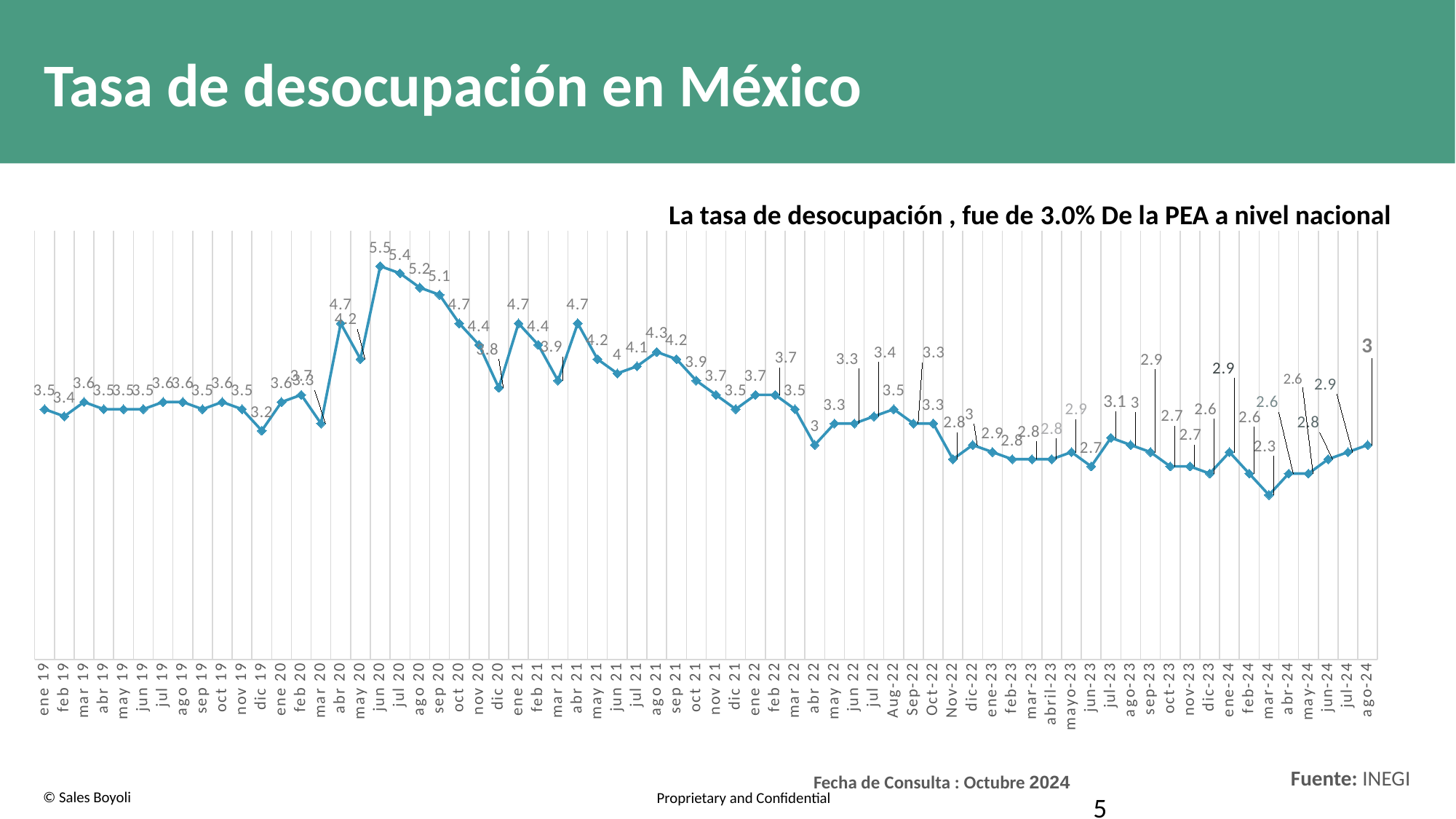
What is the value plotted for ago-24, the last point on the chart? 3 What is the unemployment rate value plotted for jun 20? 5.5 What is the difference between the value for jun 20 and the value for ago-24? 2.5 Do the values rise or fall from jun 20 to sep 20? Fall What kind of chart is shown on the slide? Line chart What is the title of the slide containing the chart? Tasa de desocupación en México Which month has the highest unemployment rate on the chart? jun 20 What is the value plotted for mar-24? 2.3 What is the value plotted for ene 19, the first point on the chart? 3.5 Which is larger, the value for abr 20 or the value for may 20? abr 20 What is the value plotted for dic 19? 3.2 Which month has the lowest unemployment rate on the chart? mar-24